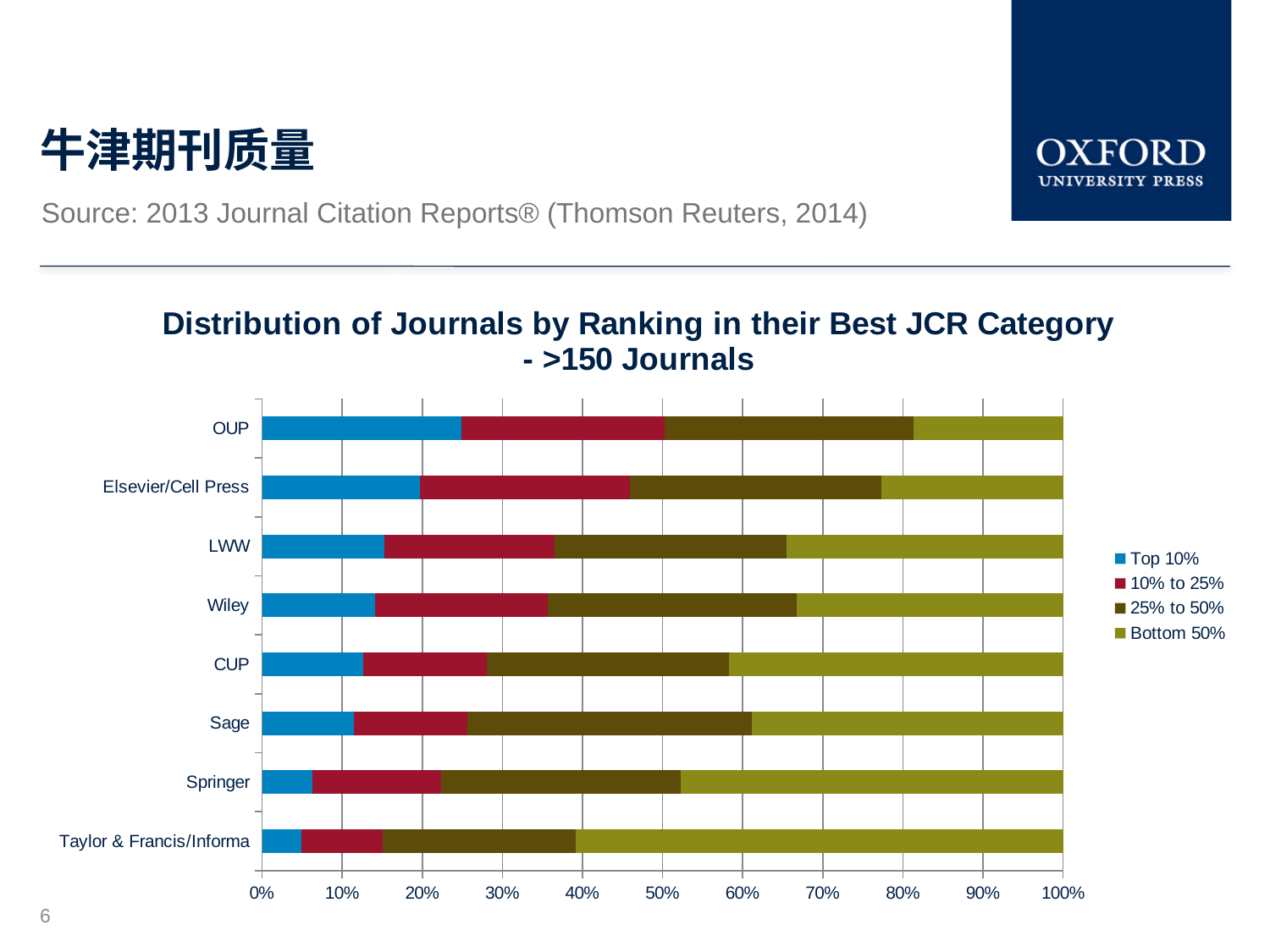
Which has the larger Top 10% segment, OUP or Elsevier/Cell Press? OUP Is the Top 10% segment for OUP greater or less than 20%? greater What kind of chart is shown on the slide? Stacked bar chart What is the title of the chart? Distribution of Journals by Ranking in their Best JCR Category - >150 Journals What does each full stacked bar total on the horizontal axis? 100% How many publishers are listed on the vertical axis of the chart? 8 Is the Top 10% segment for Springer greater or less than 10%? less Which has the larger Bottom 50% segment, OUP or Springer? Springer Is the Bottom 50% segment for Taylor & Francis/Informa greater or less than 50%? greater Which publisher has the largest Top 10% segment? OUP How many series does the chart legend list? 4 Which publisher has the smallest Top 10% segment? Taylor & Francis/Informa